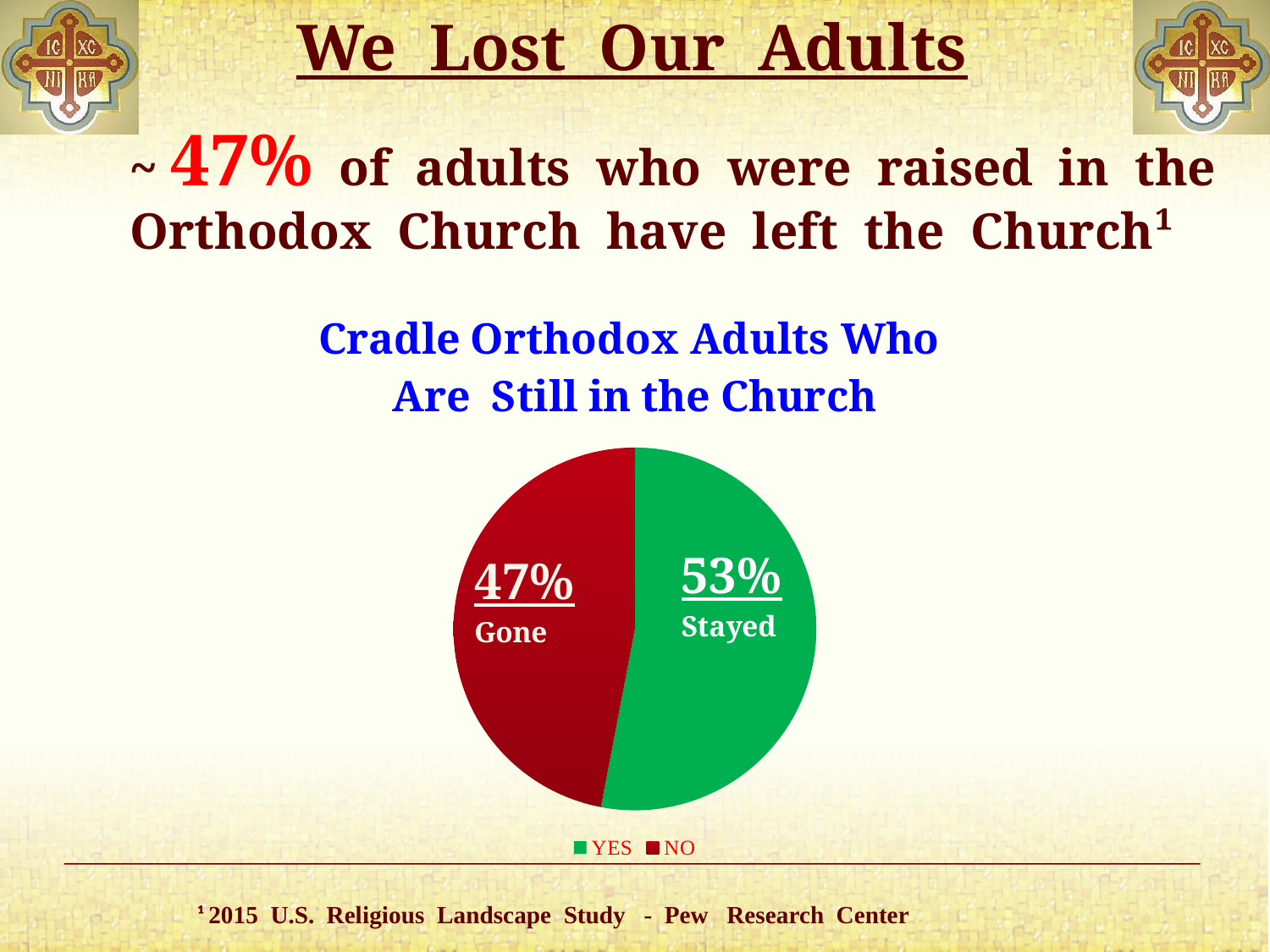
What is the difference in percentage points between the Stayed and Gone slices? 6 How many entries does the chart legend list? 2 What percentage of cradle Orthodox adults are gone according to the pie chart? 47% Which slice of the pie chart is larger, Stayed or Gone? Stayed What is the title of the chart? Cradle Orthodox Adults Who Are Still in the Church What colour is the YES slice in the pie chart? green What kind of chart is shown on the slide? pie chart Which slice of the pie chart is the smallest? Gone What share of the pie does the NO (Gone) slice represent? 47% What percentage of cradle Orthodox adults stayed in the Church according to the pie chart? 53% How many slices does the pie chart have? 2 Is the value for the Stayed slice greater or less than 50%? greater